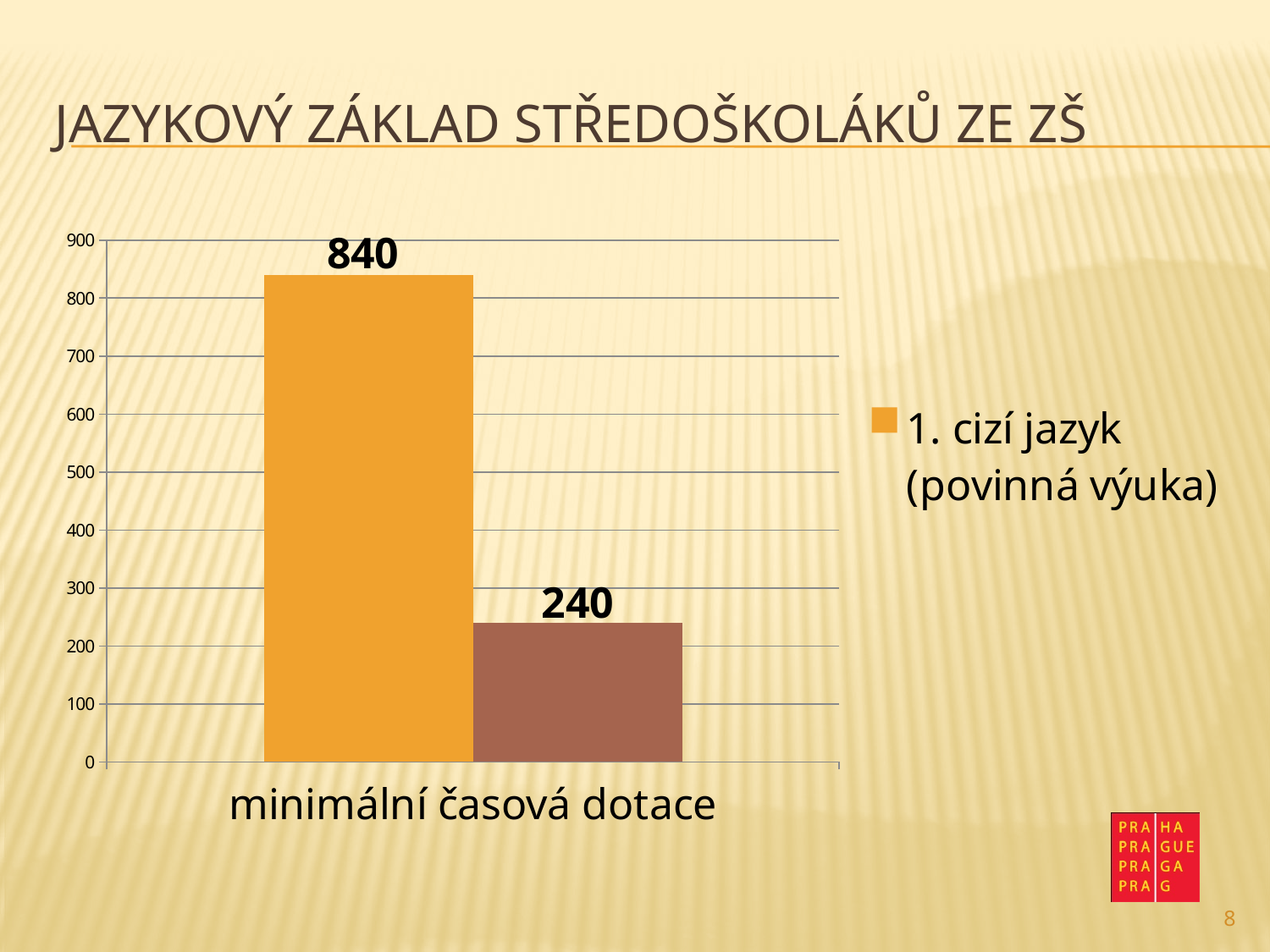
Is the value of the brown bar greater or less than 300? less What is the category label shown on the x axis? minimální časová dotace Which bar has the lowest value, the orange one or the brown one? the brown one What kind of chart is shown on the slide? bar chart What value is printed on the brown bar? 240 How many categories are shown on the x axis of the chart? 1 Is the value for "1. cizí jazyk (povinná výuka)" greater or less than 800? greater Which bar is the tallest in the chart? 1. cizí jazyk (povinná výuka) Which is larger, the orange bar or the brown bar? the orange bar What is the difference between the orange bar (840) and the brown bar (240)? 600 What is the value of the bar for "1. cizí jazyk (povinná výuka)"? 840 How many series does the legend list? 1